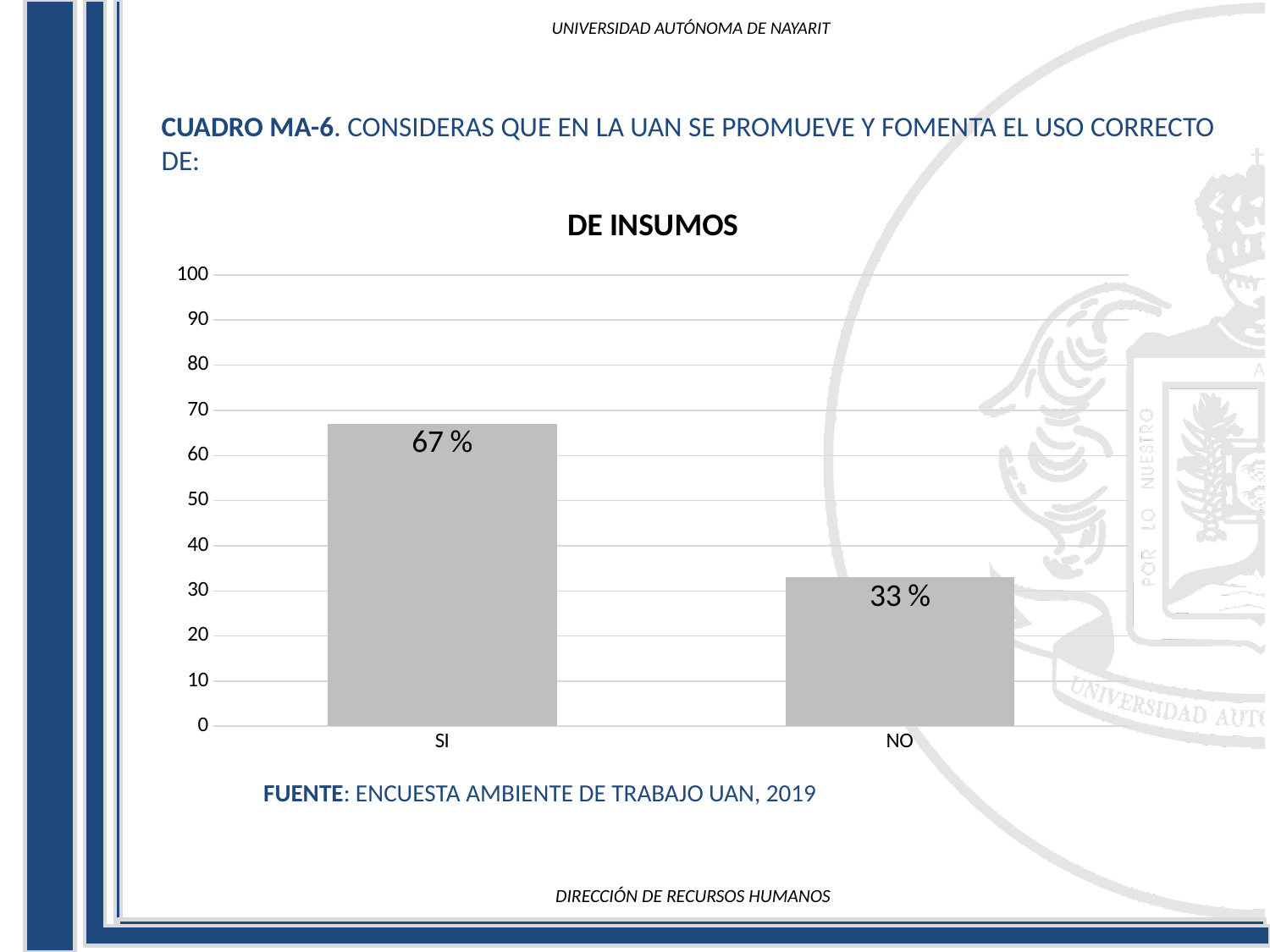
What is the value for SI? 67 % Is the value for SI greater or less than 60? greater Which category has the lowest value? NO What is the difference between the values for SI and NO? 34 % How many categories are shown on the x axis? 2 What is the title of the chart? DE INSUMOS What kind of chart is shown? bar chart Which category has the highest value? SI Which is larger, the value for SI or the value for NO? SI What is the value for NO? 33 % Is the value for NO greater or less than 40? less What is the highest value shown on the y axis? 100